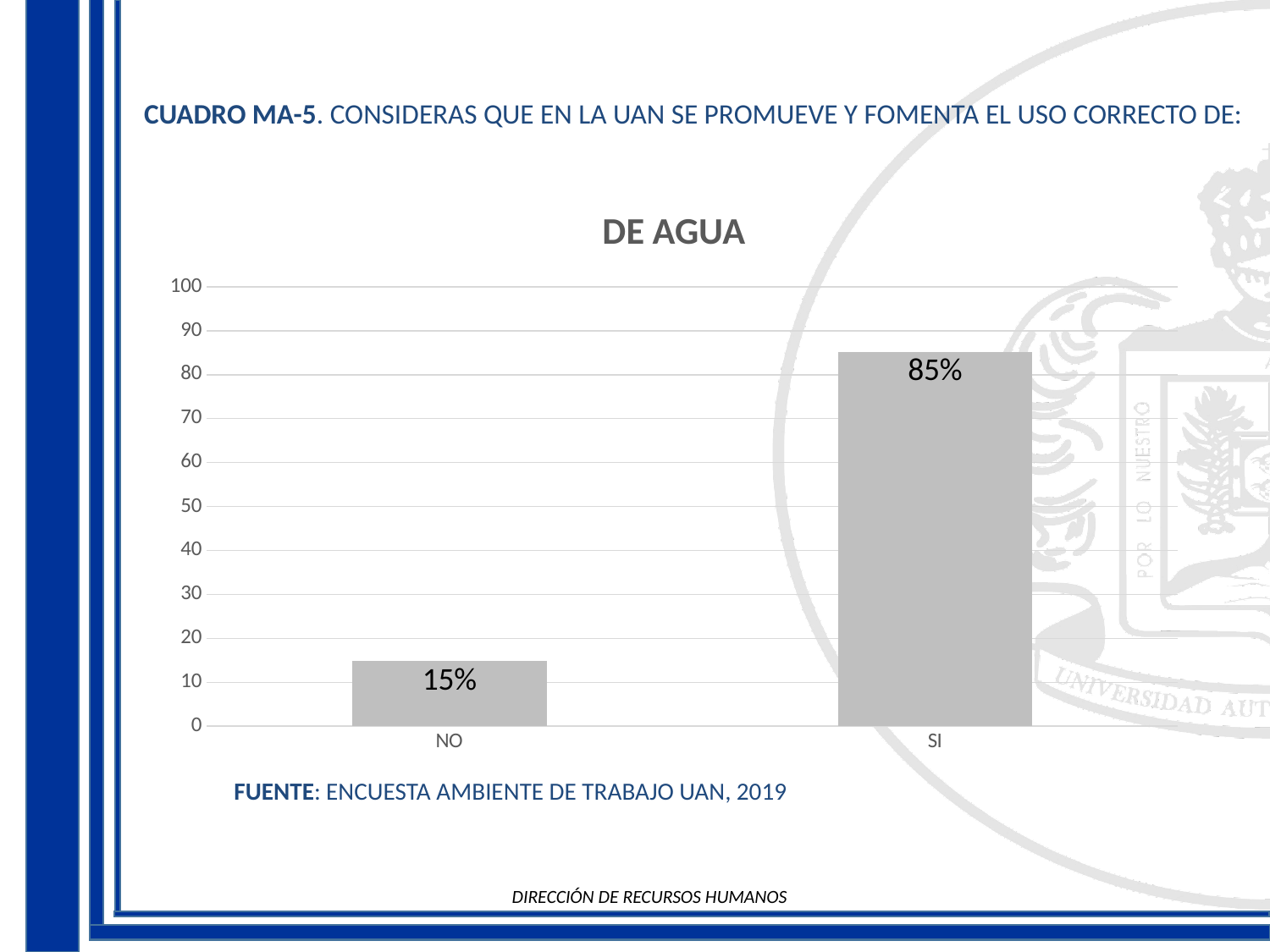
Which is larger, the value for NO or the value for SI? SI What is the difference between the values for SI and NO? 70% Is the value for NO greater or less than 20? less Which category has the highest value? SI What is the value for NO? 15% Is the value for SI greater or less than 80? greater How many categories are shown on the x axis? 2 Which category has the lowest value? NO What is the highest value shown on the y axis? 100 What kind of chart is shown? bar chart What is the value for SI? 85% What is the title of the chart? DE AGUA